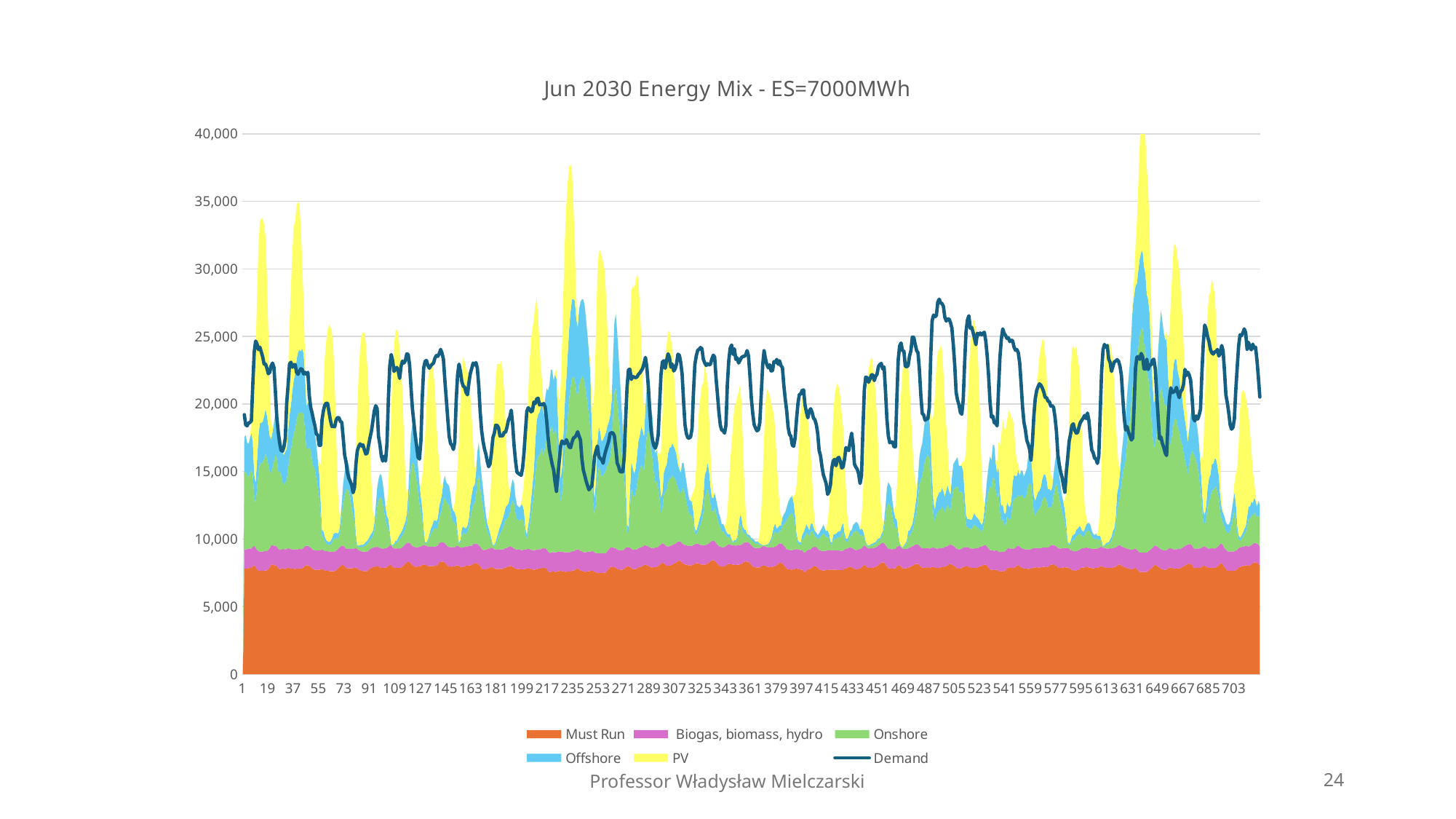
Is the highest point of the stacked total (around point 631) greater or less than 35,000? greater What is the maximum value shown on the vertical axis? 40,000 Which series is drawn as a line rather than a filled area? Demand Is the value of the Must Run series at point 1 greater or less than 10,000? less Is the Demand value at point 415 greater or less than 15,000? less What kind of chart is shown on the slide? Stacked area chart with a line series Which series forms the bottom layer of the stacked areas? Must Run What is the title of the chart? Jun 2030 Energy Mix - ES=7000MWh How many series does the legend list? 6